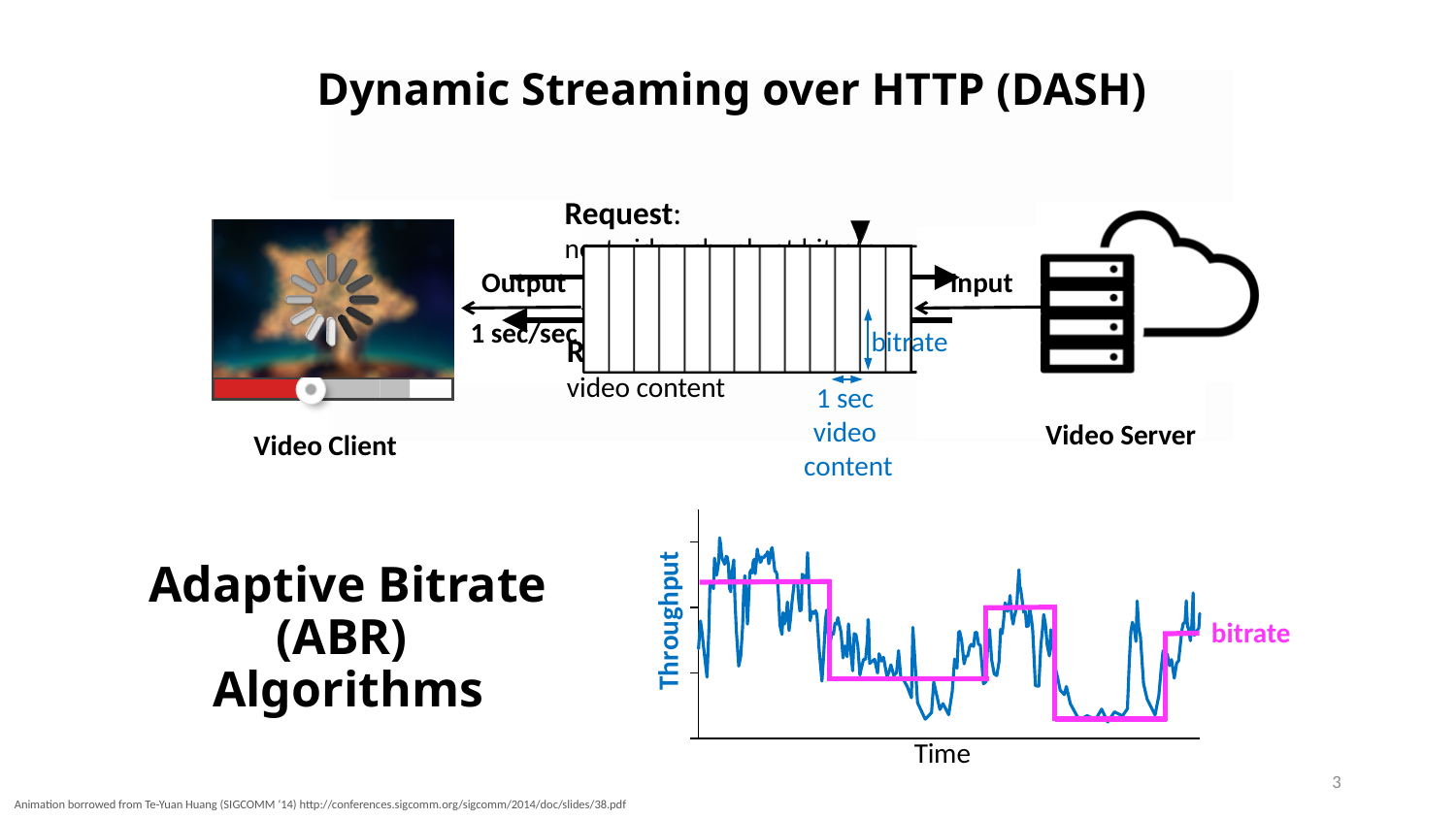
What is the label on the vertical axis of the Throughput chart? Throughput On the Throughput chart, is the bitrate level at the start of the time axis higher or lower than at the end? higher How many constant-level segments does the bitrate step line have on the Throughput chart? 5 How many lines are plotted on the Throughput chart? 2 On the Throughput chart, what does the magenta step line represent? bitrate On the Throughput chart, which segment of the bitrate step line is the lowest? the fourth segment On the Throughput chart, is the third bitrate segment higher or lower than the second bitrate segment? higher What kind of chart is shown at the bottom right of the slide? line chart On the Throughput chart, which segment of the bitrate step line is the highest? the first segment On the Throughput chart, does the bitrate step line overall rise or fall from the left end to the right end of the time axis? fall What is the label on the horizontal axis of the Throughput chart? Time